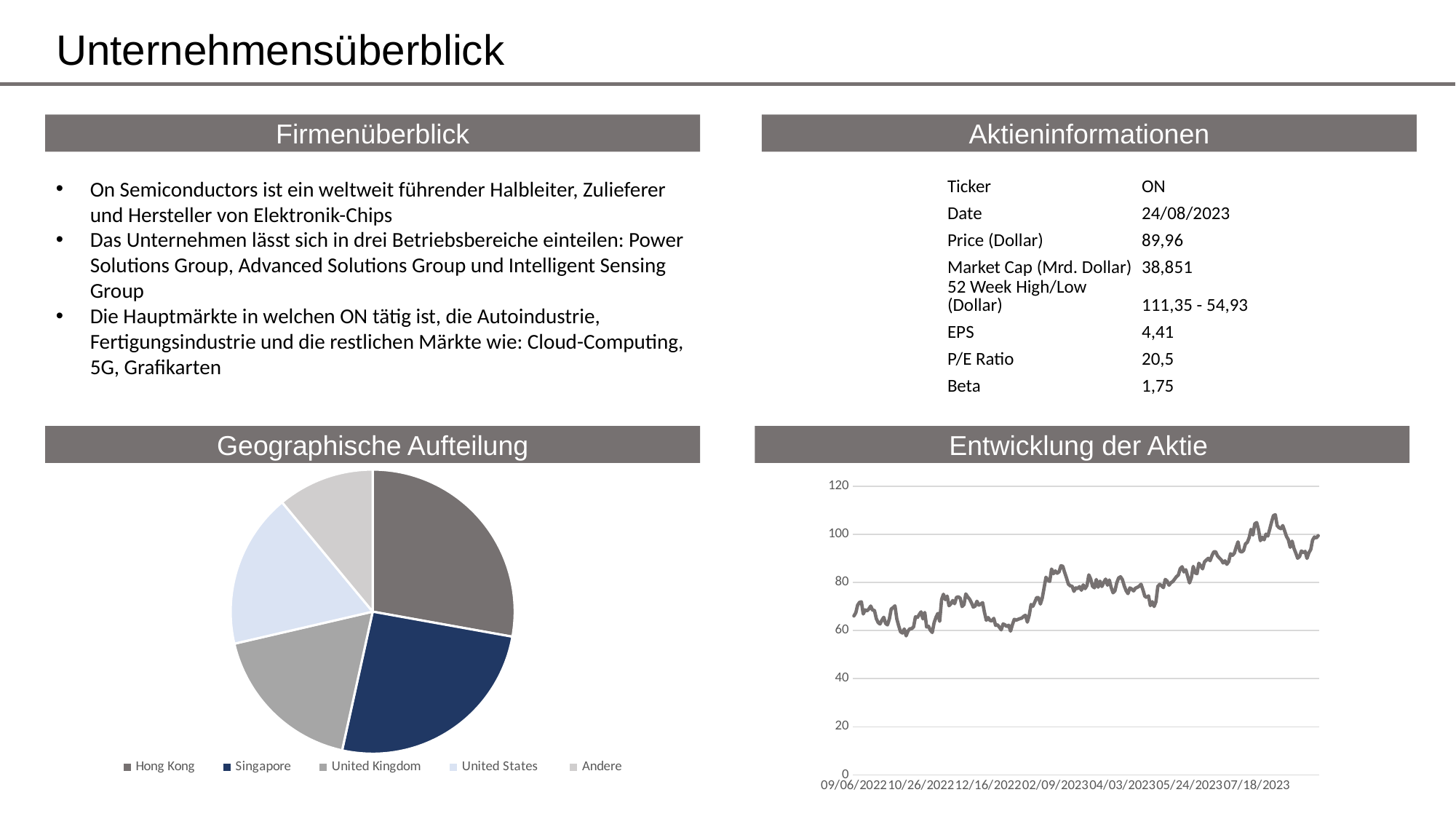
In the "Geographische Aufteilung" pie chart, which slice is larger, Singapore or Andere? Singapore How many categories does the legend of the "Geographische Aufteilung" pie chart list? 5 What kind of chart is shown under "Entwicklung der Aktie"? line chart In the "Entwicklung der Aktie" chart, is the highest point of the line greater or less than 100? greater What kind of chart is shown under "Geographische Aufteilung"? pie chart In the "Entwicklung der Aktie" chart, is the value at the last date on the x axis greater or less than 80? greater What is the highest value shown on the y axis of the "Entwicklung der Aktie" chart? 120 In the "Geographische Aufteilung" pie chart, which category has the largest slice? Hong Kong In the "Geographische Aufteilung" pie chart, which slice is larger, Hong Kong or United Kingdom? Hong Kong In the "Entwicklung der Aktie" chart, does the value overall rise or fall from the start of the x axis to the end? rise In the "Geographische Aufteilung" pie chart, which category has the smallest slice? Andere In the "Geographische Aufteilung" pie chart, what colour is the Singapore slice? dark blue